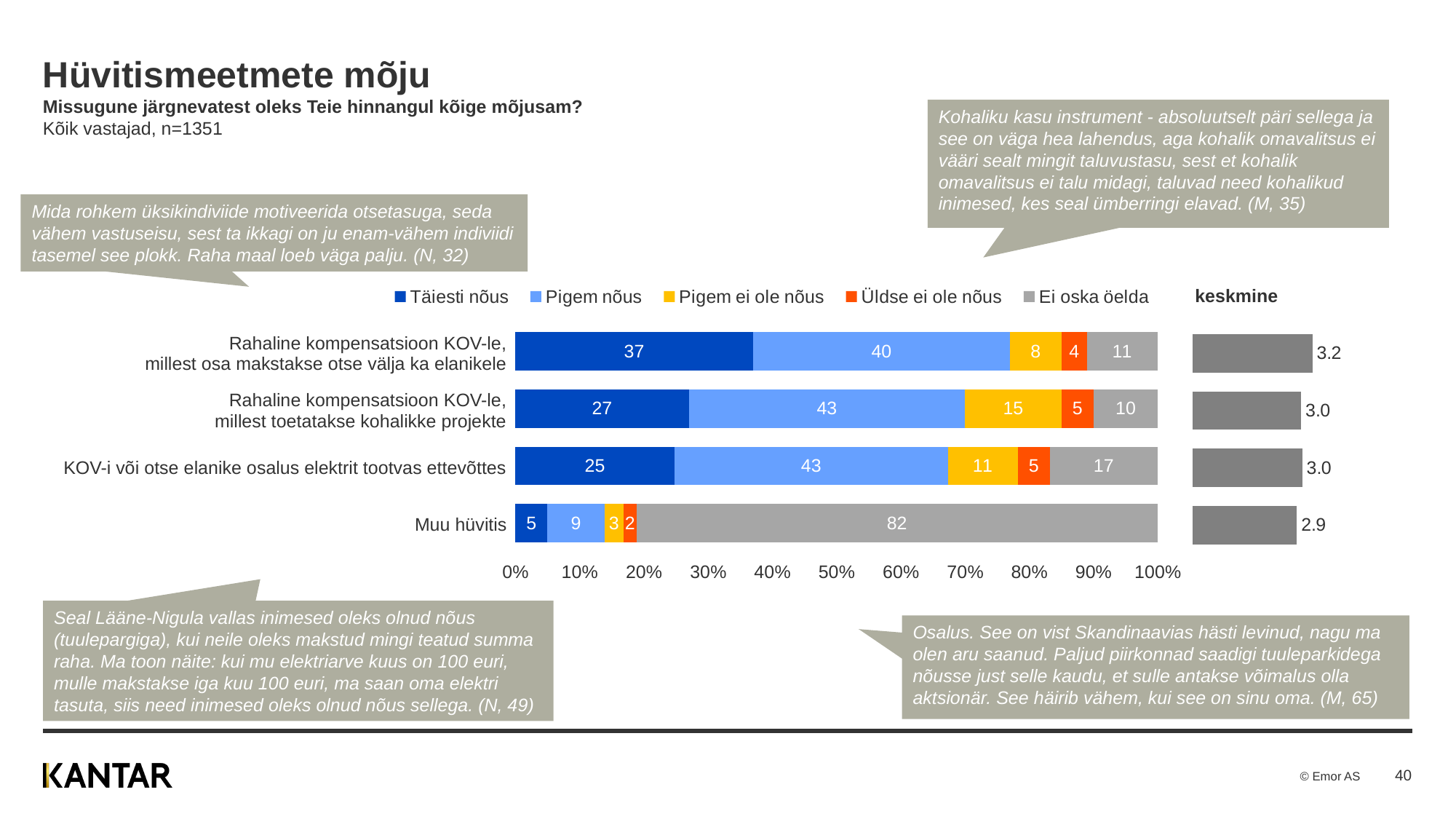
What is the "Ei oska öelda" value for "Muu hüvitis"? 82 What is the "Täiesti nõus" value for "Rahaline kompensatsioon KOV-le, millest osa makstakse otse välja ka elanikele"? 37 How many series does the legend of the stacked bar chart list? 5 What is the keskmine (average) value shown for "KOV-i või otse elanike osalus elektrit tootvas ettevõttes"? 3.0 What is the "Pigem ei ole nõus" value for "Rahaline kompensatsioon KOV-le, millest toetatakse kohalikke projekte"? 15 How many categories (bars) are shown in the stacked bar chart? 4 Which category has the lowest keskmine (average) value? Muu hüvitis What kind of chart is used to show the response distribution? Stacked bar chart Which category has the highest "Täiesti nõus" value? Rahaline kompensatsioon KOV-le, millest osa makstakse otse välja ka elanikele What is the difference between the "Pigem nõus" values for "Rahaline kompensatsioon KOV-le, millest toetatakse kohalikke projekte" and "Muu hüvitis"? 34 Which is larger: the "Ei oska öelda" value for "KOV-i või otse elanike osalus elektrit tootvas ettevõttes" or for "Rahaline kompensatsioon KOV-le, millest toetatakse kohalikke projekte"? KOV-i või otse elanike osalus elektrit tootvas ettevõttes What is the combined "Täiesti nõus" and "Pigem nõus" value for "KOV-i või otse elanike osalus elektrit tootvas ettevõttes"? 68